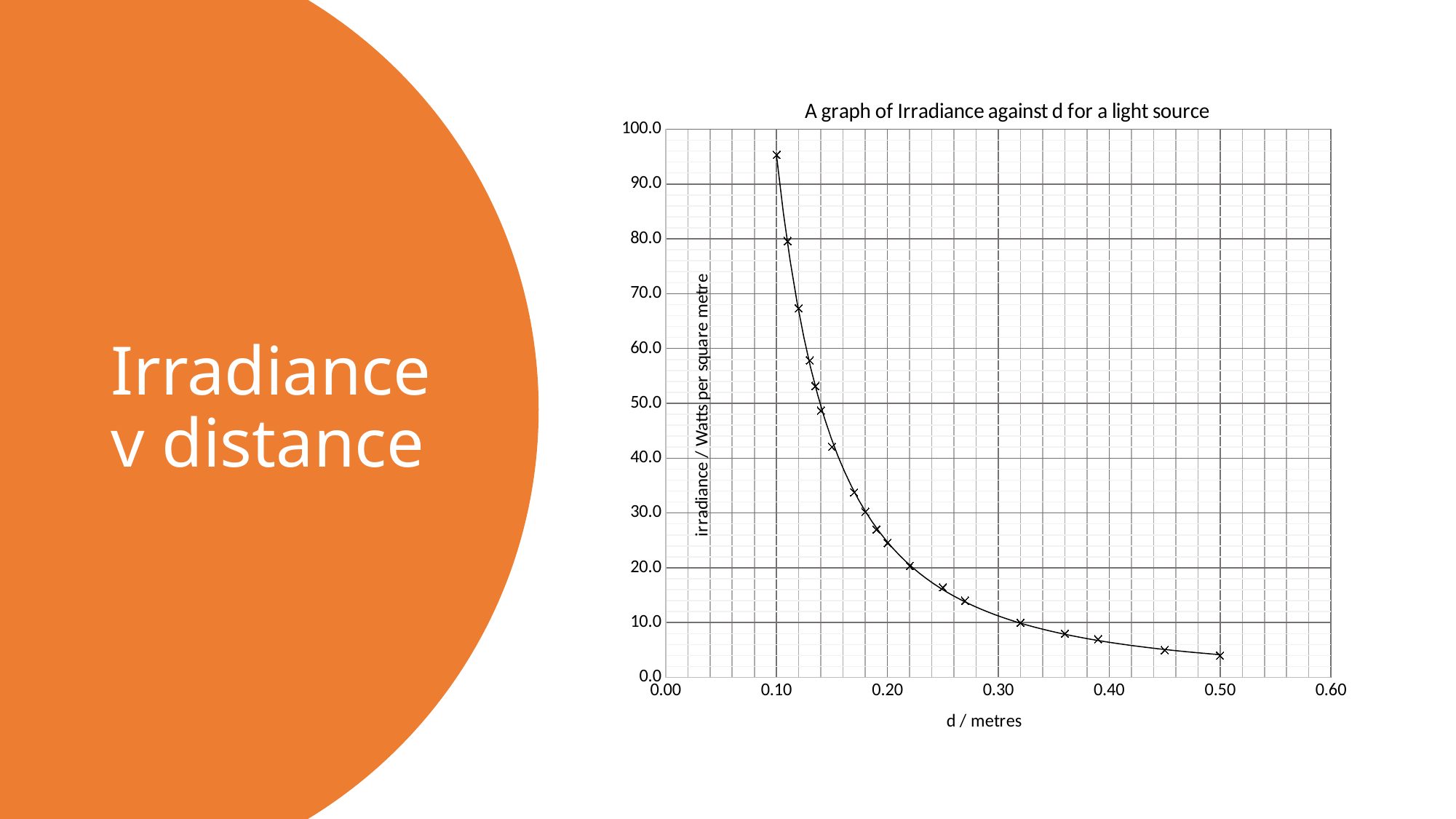
What is the label on the y axis of the chart? irradiance / Watts per square metre Is the irradiance at d = 0.15 metres greater or less than 50? less At which value of d is the irradiance lowest? 0.50 Is the irradiance at d = 0.20 metres greater or less than 30? less Does irradiance rise or fall as d increases along the x axis? fall Which has the larger irradiance, d = 0.10 metres or d = 0.20 metres? d = 0.10 metres Is the irradiance at d = 0.25 metres greater or less than 20? less What is the title of the chart? A graph of Irradiance against d for a light source At which value of d is the irradiance highest? 0.10 What kind of chart is shown on the slide? line chart